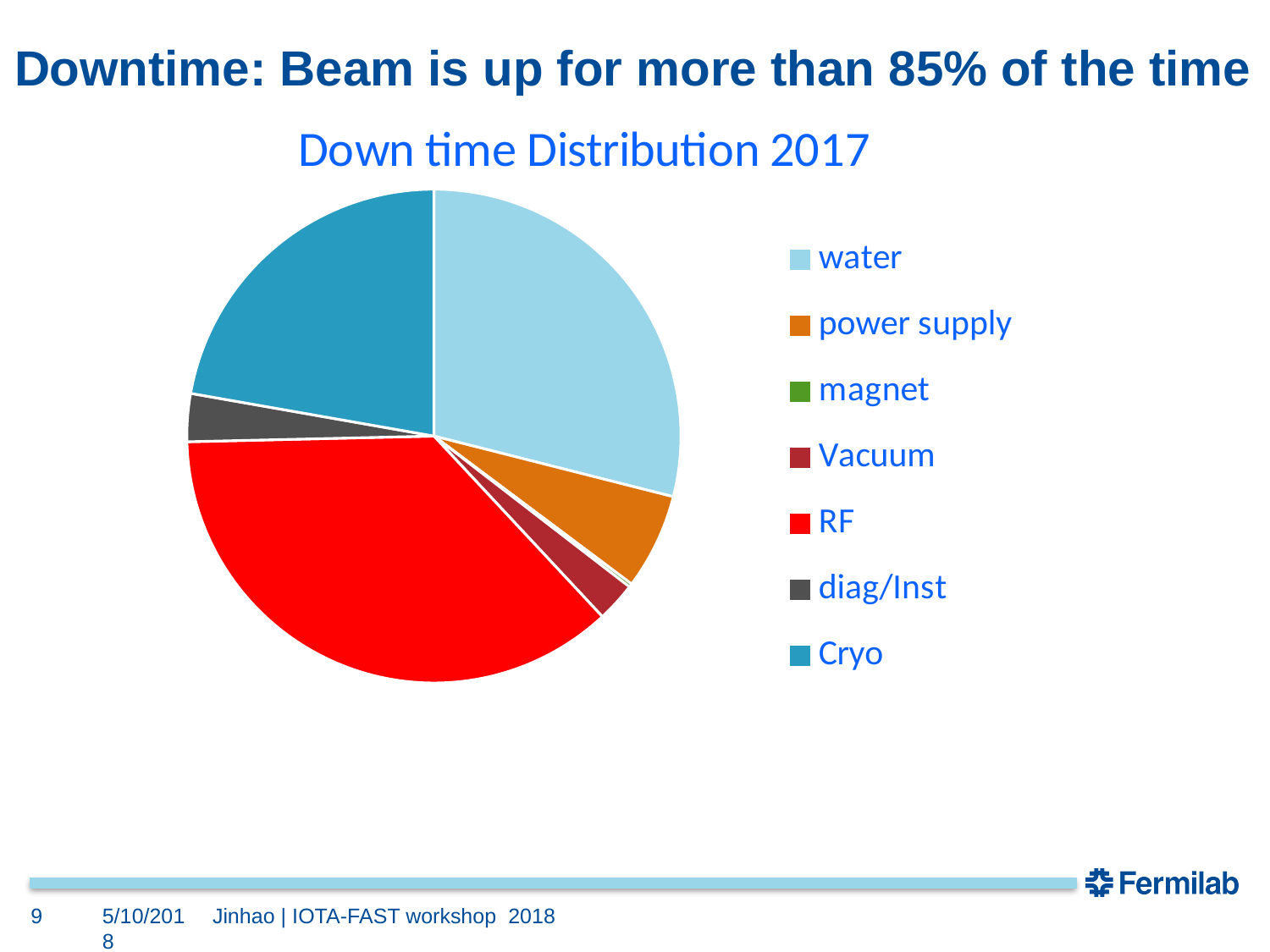
Which category has the smallest slice of the pie? magnet Which slice is larger, water or Cryo? water Which slice is larger, Cryo or diag/Inst? Cryo Which slice is larger, Vacuum or magnet? Vacuum How many categories does the pie chart's legend list? 7 What colour is the RF slice in the pie chart? red Which category has the largest slice of the pie? RF What kind of chart is shown on the slide? pie chart What is the title of the chart? Down time Distribution 2017 Which category is listed first in the legend? water